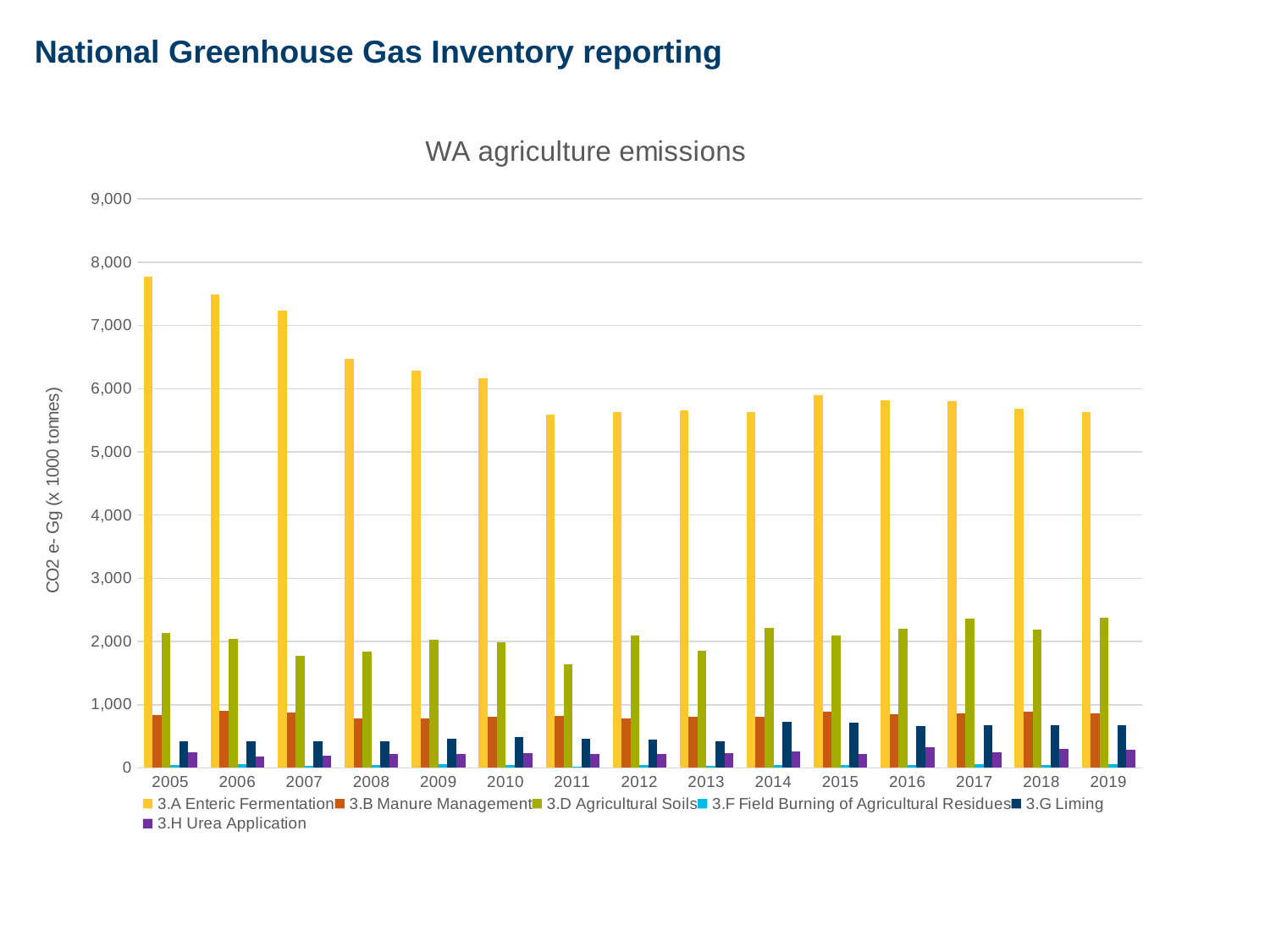
How many series does the legend list? 6 Which series has the lowest value in 2019? 3.F Field Burning of Agricultural Residues Which series has the highest value in 2005? 3.A Enteric Fermentation Is the value for 3.A Enteric Fermentation in 2005 greater or less than 7,000? greater Does the value for 3.A Enteric Fermentation rise or fall from 2005 to 2011? fall In which year is the value for 3.D Agricultural Soils lowest? 2011 Is the value for 3.D Agricultural Soils in 2011 greater or less than 2,000? less What kind of chart is shown on the slide? bar chart In which year is the value for 3.A Enteric Fermentation highest? 2005 Is the value for 3.A Enteric Fermentation in 2019 greater or less than 6,000? less Which is larger, the value for 3.A Enteric Fermentation in 2005 or in 2019? 2005 How many years are shown on the x axis? 15